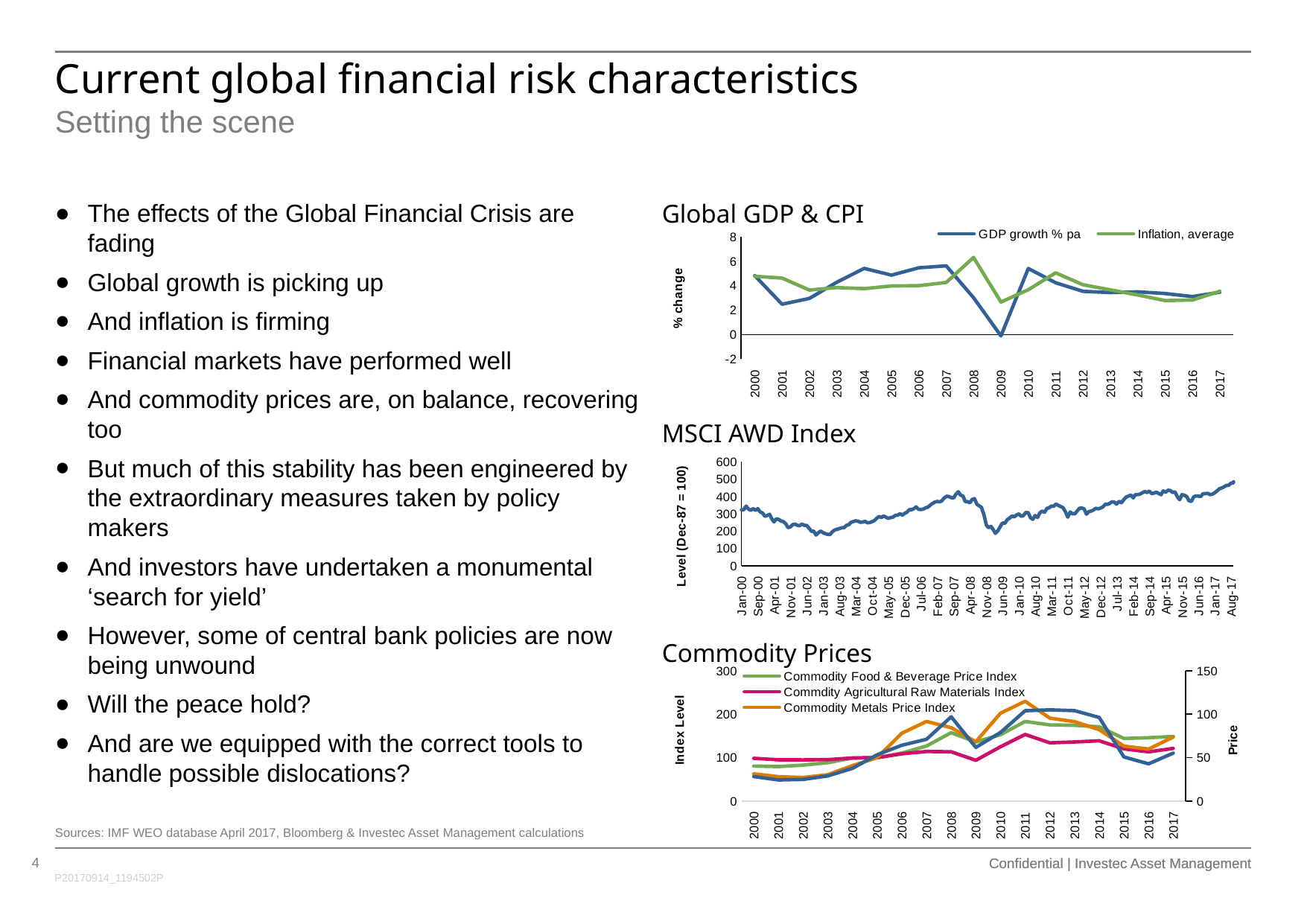
How many series does the legend of the Commodity Prices chart list? 3 In the Global GDP & CPI chart, which series has the higher value in 2009, GDP growth % pa or Inflation, average? Inflation, average What is the y-axis label of the MSCI AWD Index chart? Level (Dec-87 = 100) What kind of chart is the Global GDP & CPI chart? Line chart What kind of chart is the MSCI AWD Index chart? Line chart In the Commodity Prices chart, is the Commodity Metals Price Index value for 2011 greater or less than 200? greater In the Global GDP & CPI chart, is the Inflation, average value for 2008 greater or less than 4? greater In the MSCI AWD Index chart, does the index rise or fall between Jan-00 and Jan-03? Fall In the Global GDP & CPI chart, which year has the lowest GDP growth % pa value? 2009 In the Global GDP & CPI chart, is the GDP growth % pa value for 2009 greater or less than 2? less How many series does the legend of the Global GDP & CPI chart list? 2